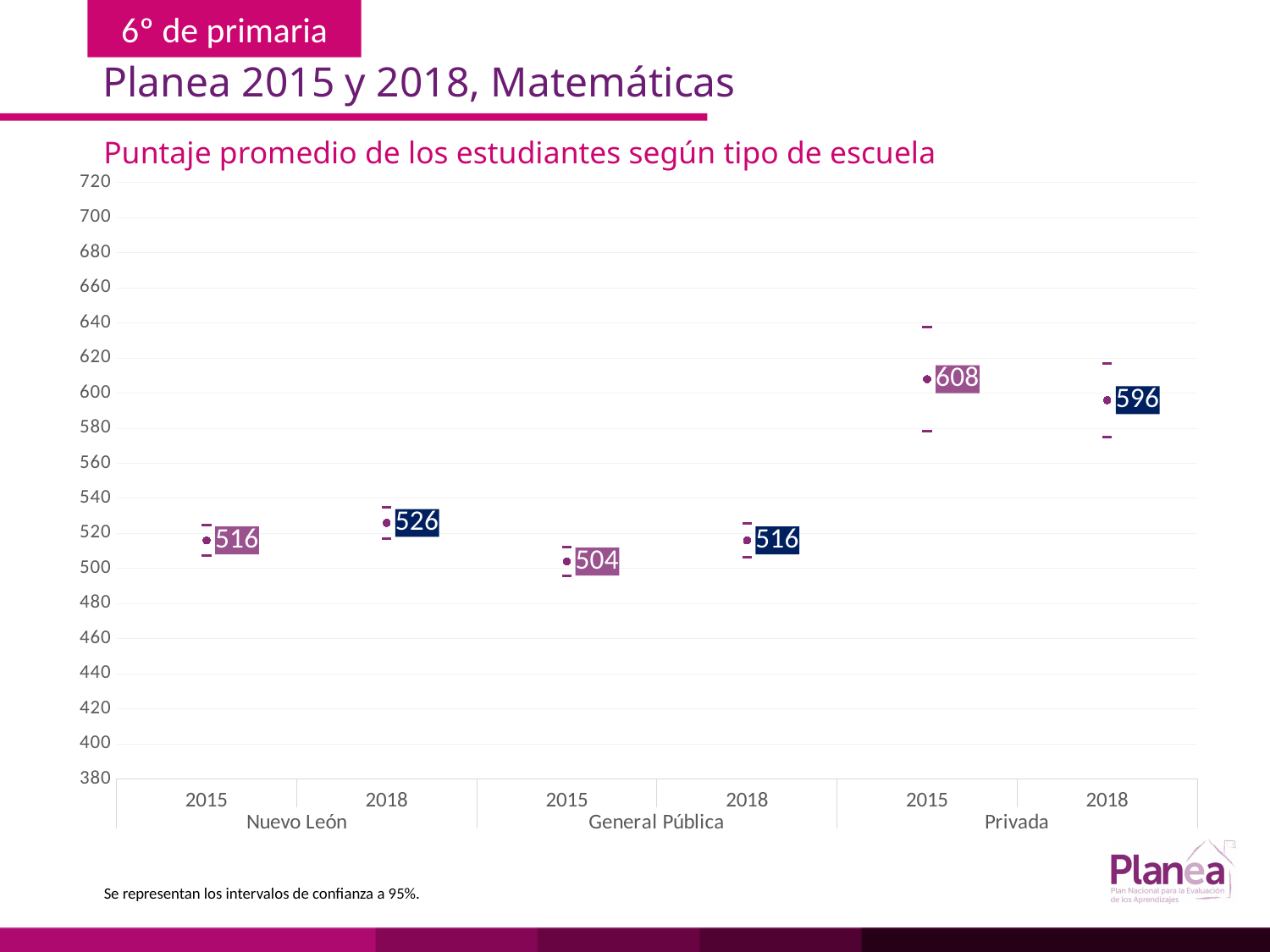
Which group and year has the highest average score? Privada 2015 What is the average score for Nuevo León in 2018? 526 How many data points are plotted on the chart? 6 Which is larger, the General Pública score in 2018 or the Nuevo León score in 2018? Nuevo León 2018 What is the average score for General Pública in 2015? 504 What is the difference between the Privada scores in 2015 and 2018? 12 By how much did the Nuevo León score change from 2015 to 2018? 10 Which group and year has the lowest average score? General Pública 2015 What is the title of the chart? Puntaje promedio de los estudiantes según tipo de escuela What is the average score for Nuevo León in 2015? 516 Is the Privada score in 2015 greater or less than 600? greater What is the average score for Privada in 2018? 596